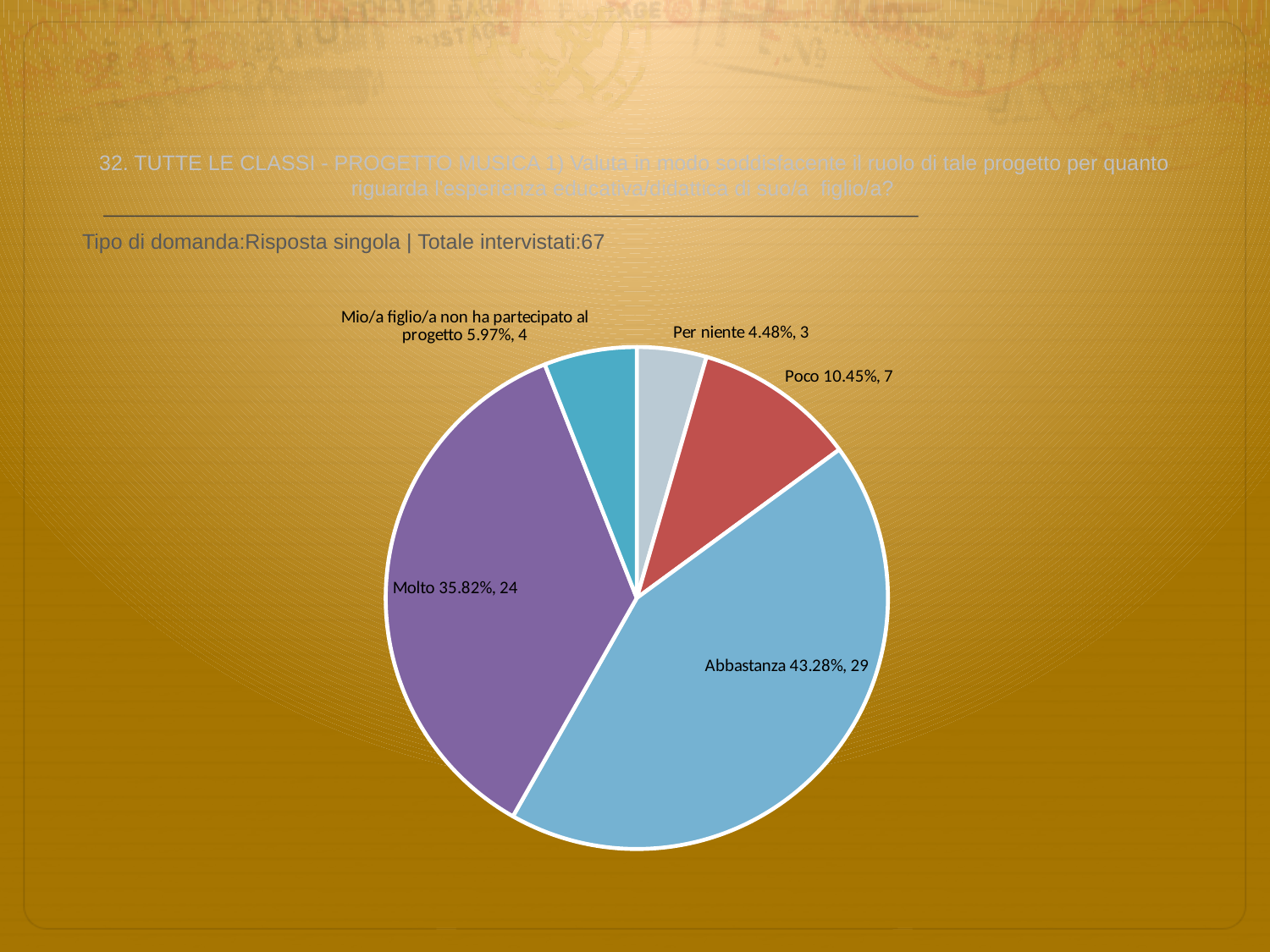
What kind of chart is shown on the slide? pie chart What is the total number of interviewees stated on the slide? 67 What percentage share does the 'Mio/a figlio/a non ha partecipato al progetto' slice have? 5.97% Which category has the smallest slice? Per niente What percentage share does the 'Poco' slice have? 10.45% How many respondents answered 'Per niente'? 3 Which has more respondents, 'Poco' or 'Mio/a figlio/a non ha partecipato al progetto'? Poco What percentage share does the 'Abbastanza' slice have? 43.28% What is the difference in respondent count between 'Abbastanza' and 'Molto'? 5 Which category has the largest slice? Abbastanza How many respondents answered 'Molto'? 24 How many slices does the pie chart have? 5